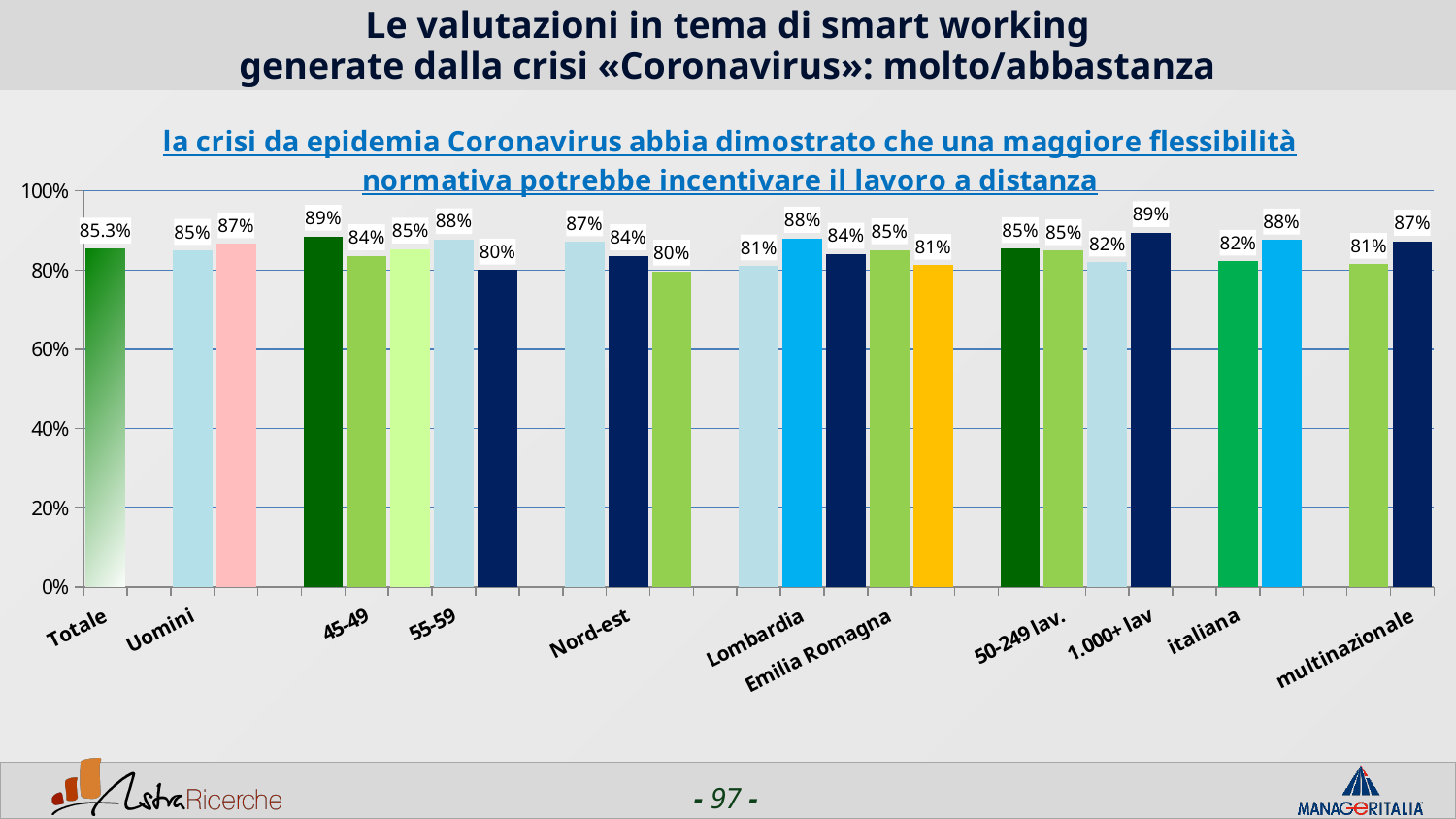
Which is larger, the value for multinazionale or the value for italiana? multinazionale What is the value for Totale? 85.3% What is the highest value shown on the vertical axis? 100% Is the value for Totale greater or less than 80%? greater What is the value for italiana? 82% What is the difference between the values for Totale and Uomini? 0.3% Which is larger, the value for Lombardia or the value for Nord-est? Lombardia What is the value for Lombardia? 88% What is the value for Uomini? 85% What is the value for 1.000+ lav? 89% What is the value for multinazionale? 87% What kind of chart is shown on the slide? bar chart